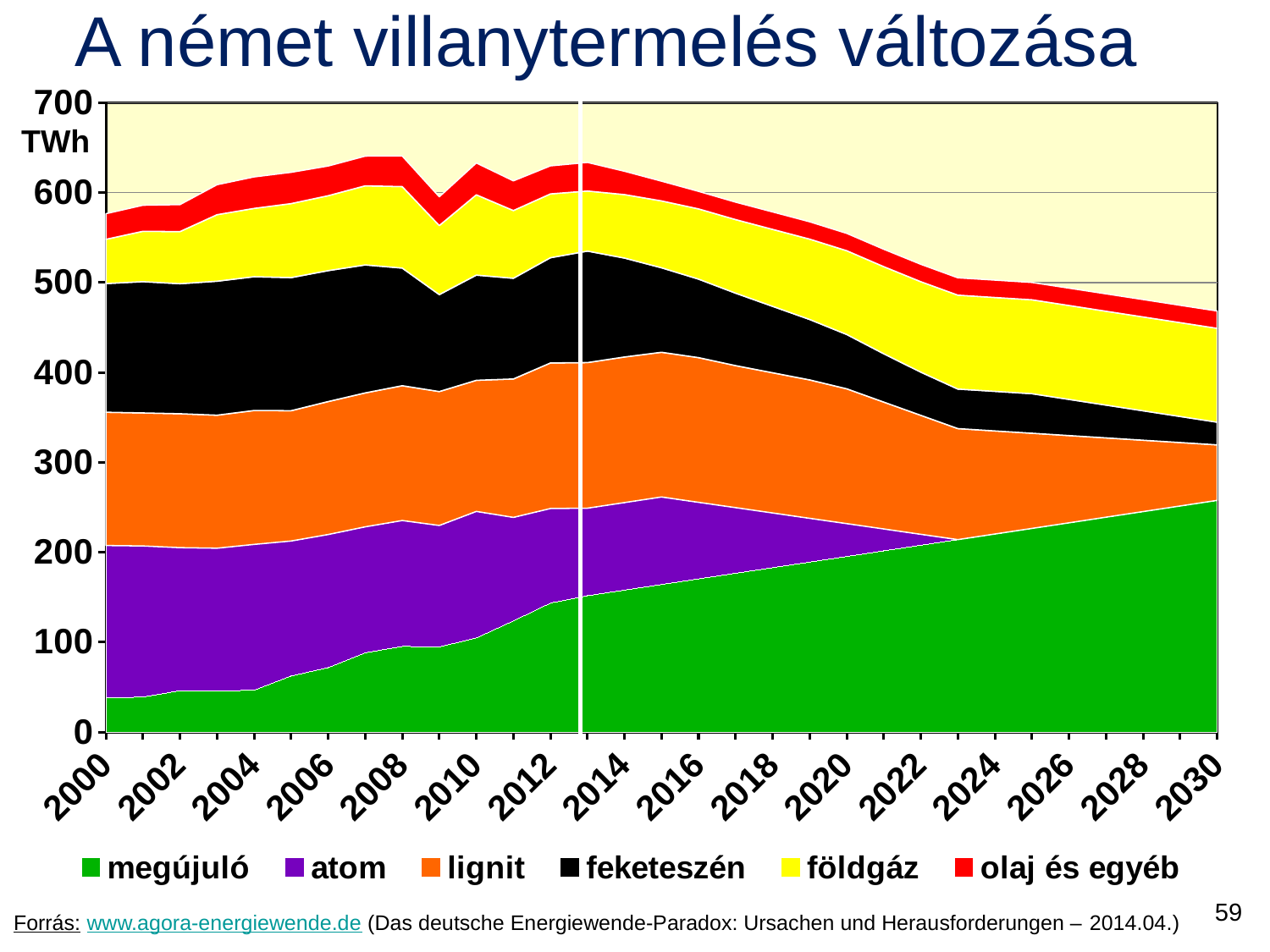
What unit is shown on the vertical axis? TWh Which series is shown in yellow in the legend? földgáz How many series does the legend list? 6 Is the total stacked value in 2030 greater or less than 500? less What is the title of the chart? A német villanytermelés változása Does the megújuló (green) area rise or fall from 2000 to 2030? rise Is the value for megújuló in 2030 greater or less than 200? greater Is the total stacked value in 2000 greater or less than 500? greater Does the atom (purple) area rise or fall from 2016 to 2022? fall What kind of chart is shown on the slide? stacked area chart Does the total stacked value rise or fall from 2014 to 2030? fall